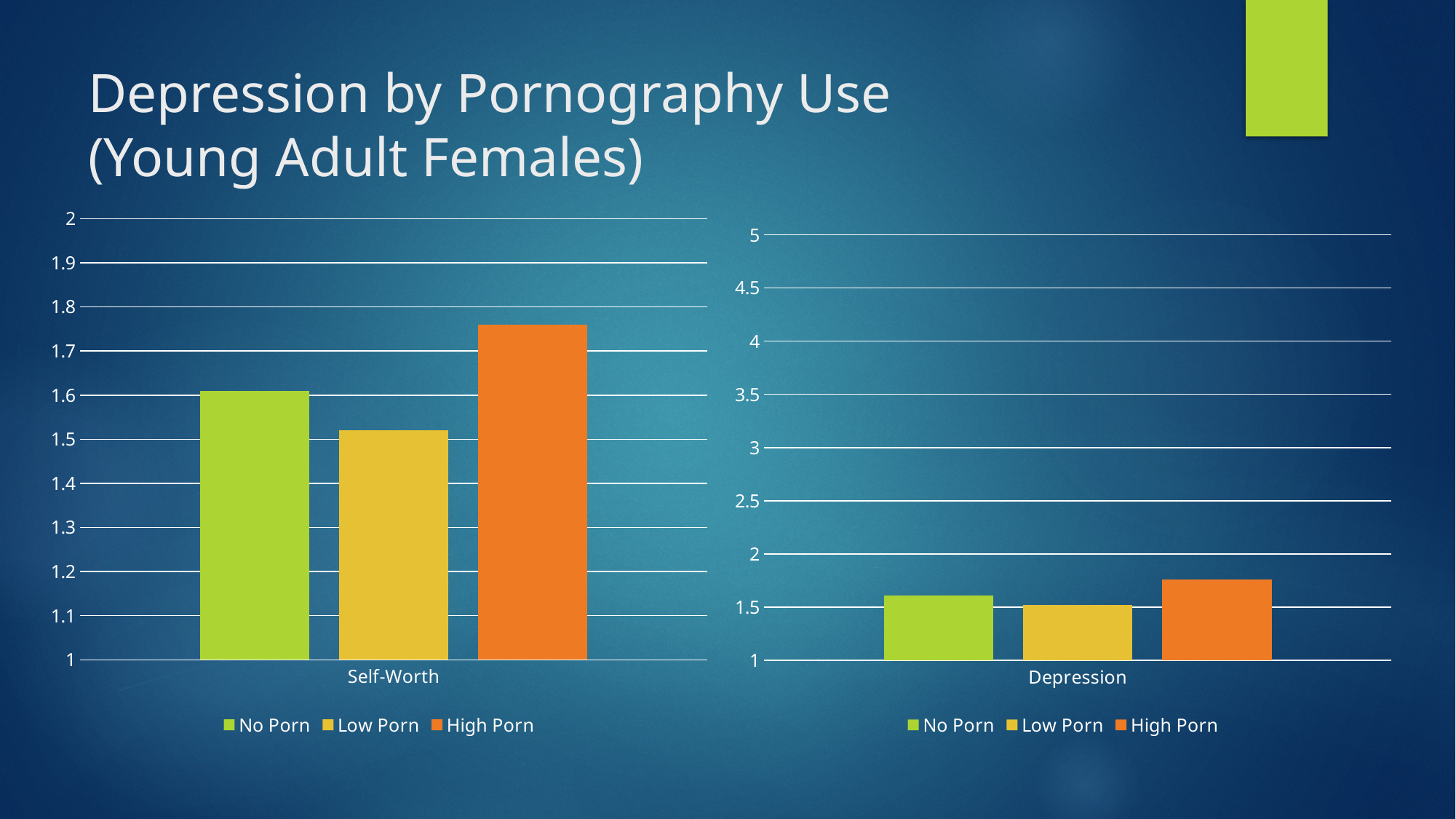
On the left chart (Self-Worth), which series has the highest bar? High Porn On the right chart (Depression), is the value for No Porn greater or less than 1.5? greater On the left chart (Self-Worth), which is larger, the No Porn bar or the Low Porn bar? No Porn How many series does the legend of the right chart (Depression) list? 3 On the left chart (Self-Worth), is the value for High Porn greater or less than 1.7? greater On the left chart (Self-Worth), is the value for Low Porn greater or less than 1.6? less On the right chart (Depression), which series has the highest bar? High Porn On the left chart (Self-Worth), which series has the lowest bar? Low Porn What is the title of the slide? Depression by Pornography Use (Young Adult Females) What kind of chart is the left chart (Self-Worth)? Bar chart